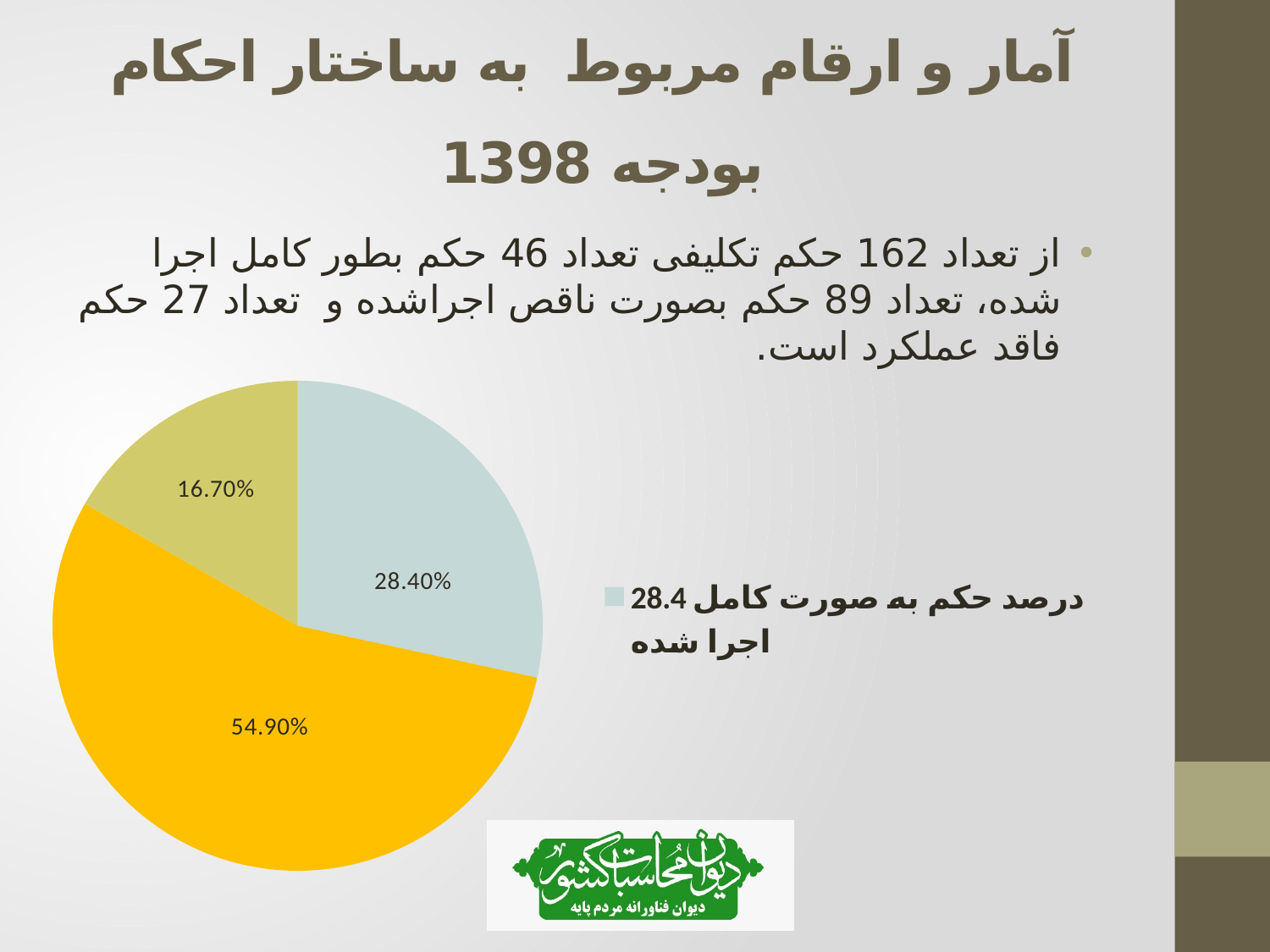
What value is labelled on the yellow slice of the pie chart? 54.90% What value is labelled on the light blue slice of the pie chart? 28.40% What kind of chart is shown on the slide? pie chart Which colour is the slice that the legend entry 'درصد حکم به صورت کامل اجرا شده 28.4' refers to? light blue What is the value for the legend entry 'درصد حکم به صورت کامل اجرا شده' in the pie chart? 28.40% What is the largest value shown on the pie chart? 54.90% How many slices does the pie chart have? 3 How many entries does the legend of the pie chart list? 1 What is the difference between the largest slice (54.90%) and the smallest slice (16.70%) of the pie chart? 38.20% What value is labelled on the olive-coloured slice of the pie chart? 16.70% Which slice is larger in the pie chart, the light blue slice or the olive slice? the light blue slice What is the smallest value shown on the pie chart? 16.70%